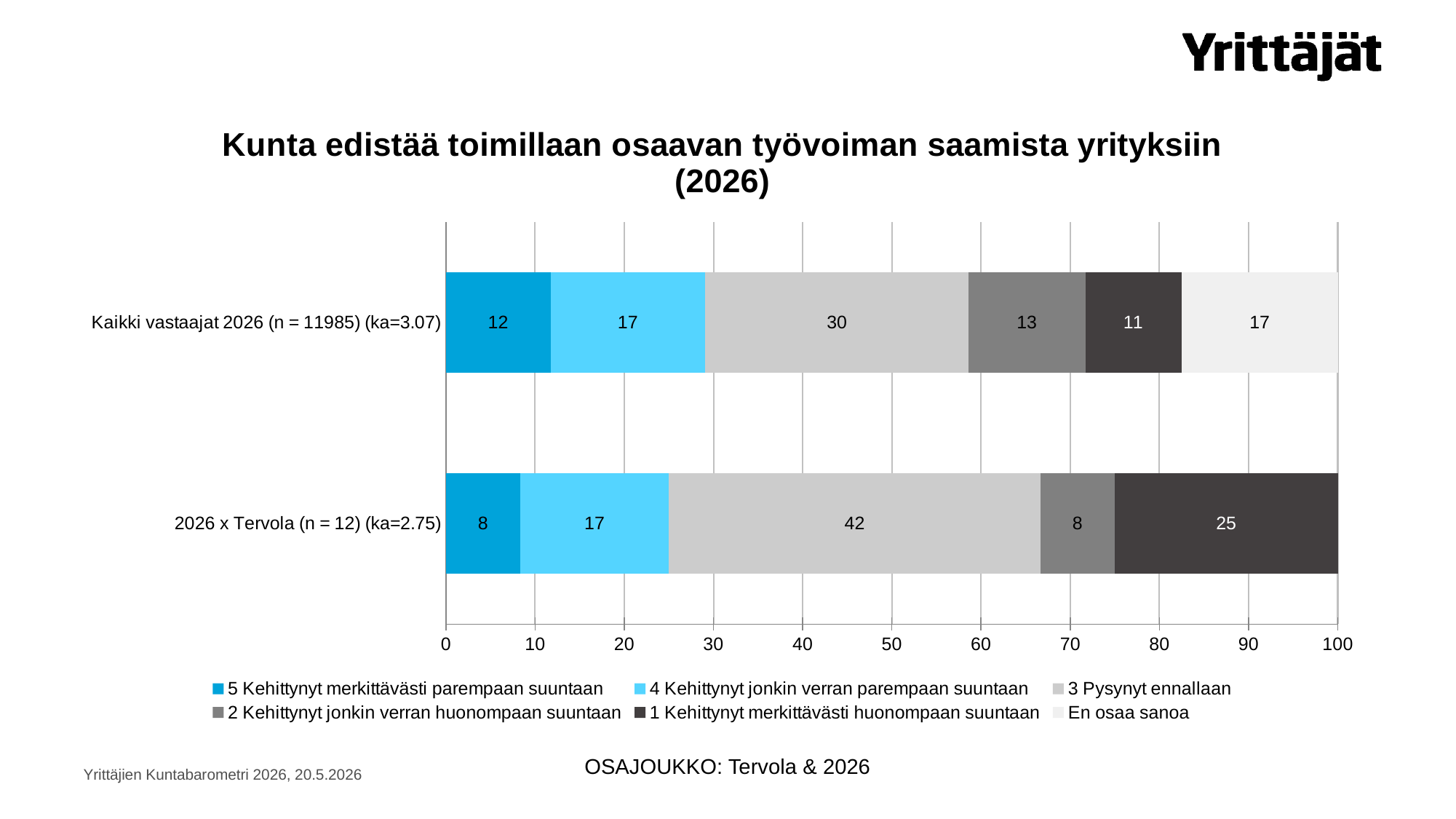
What is the total of the stacked bar for '2026 x Tervola (n = 12) (ka=2.75)'? 100 What is the difference between the '1 Kehittynyt merkittävästi huonompaan suuntaan' values for '2026 x Tervola (n = 12) (ka=2.75)' and 'Kaikki vastaajat 2026 (n = 11985) (ka=3.07)'? 14 How many categories (bars) are shown in the chart? 2 Is the '5 Kehittynyt merkittävästi parempaan suuntaan' value larger for 'Kaikki vastaajat 2026 (n = 11985) (ka=3.07)' or for '2026 x Tervola (n = 12) (ka=2.75)'? Kaikki vastaajat 2026 (n = 11985) (ka=3.07) What is the title of the chart? Kunta edistää toimillaan osaavan työvoiman saamista yrityksiin (2026) What is the value of '3 Pysynyt ennallaan' for '2026 x Tervola (n = 12) (ka=2.75)'? 42 Which category has the higher value for '3 Pysynyt ennallaan'? 2026 x Tervola (n = 12) (ka=2.75) What is the value of '1 Kehittynyt merkittävästi huonompaan suuntaan' for 'Kaikki vastaajat 2026 (n = 11985) (ka=3.07)'? 11 What is the value of '5 Kehittynyt merkittävästi parempaan suuntaan' for '2026 x Tervola (n = 12) (ka=2.75)'? 8 How many series does the legend list? 6 What is the value of 'En osaa sanoa' for 'Kaikki vastaajat 2026 (n = 11985) (ka=3.07)'? 17 What kind of chart is shown on the slide? Stacked bar chart